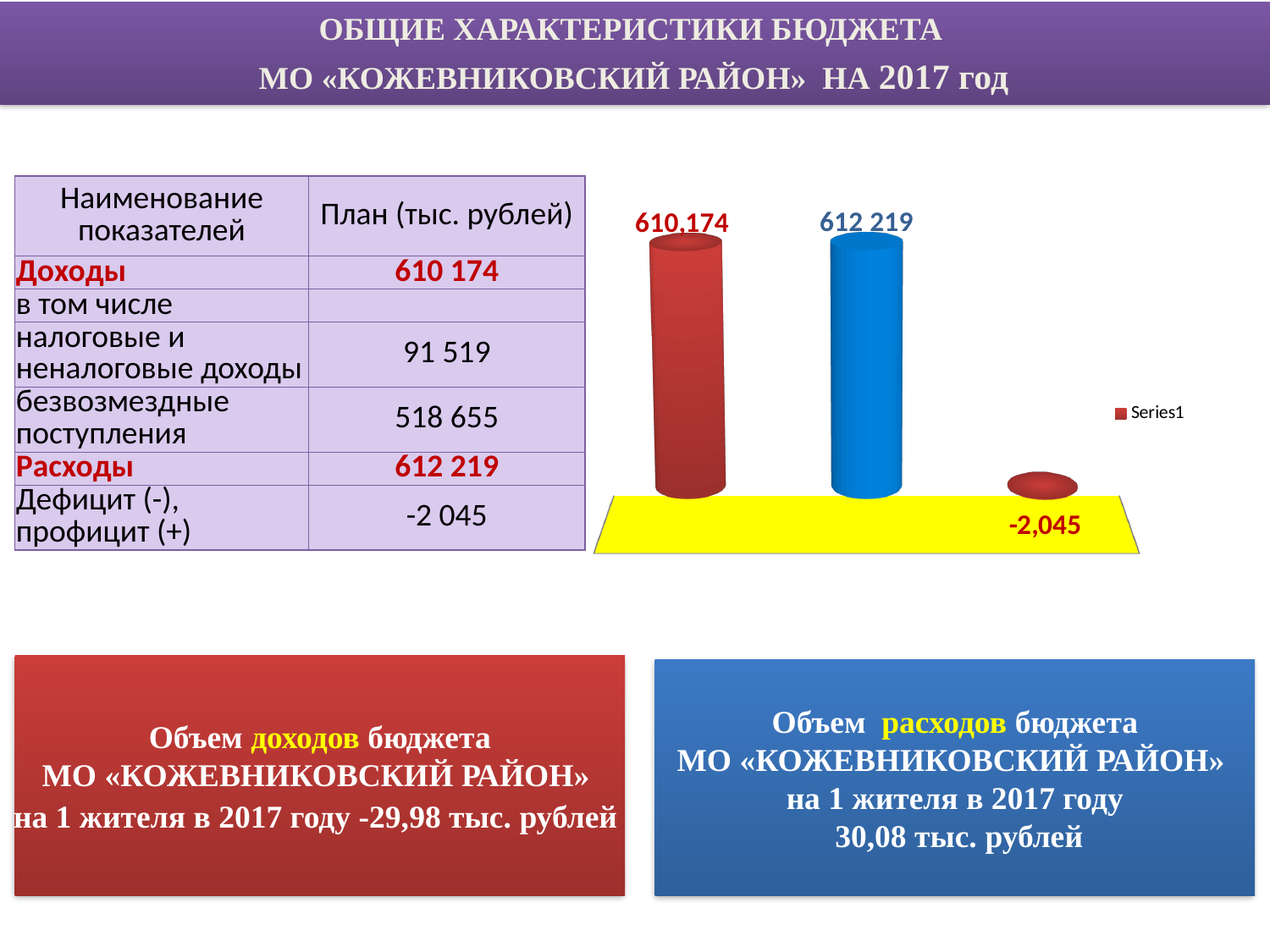
Which is larger according to the data labels: the leftmost bar or the middle bar? the middle bar Which bar in the chart has the lowest value? the rightmost bar (-2,045) What is the name of the series shown in the chart legend? Series1 What is the data label on the middle (blue) bar of the chart? 612 219 What kind of chart is shown on the slide? bar chart How many bars are plotted in the chart? 3 How many series does the chart legend list? 1 What is the difference between the middle bar's value (612 219) and the leftmost bar's value (610,174)? 2,045 What is the data label on the leftmost (red) bar of the chart? 610,174 What colour is the middle bar in the chart? blue Which bar in the chart has the highest value? the middle blue bar (612 219) What is the data label on the rightmost bar of the chart? -2,045